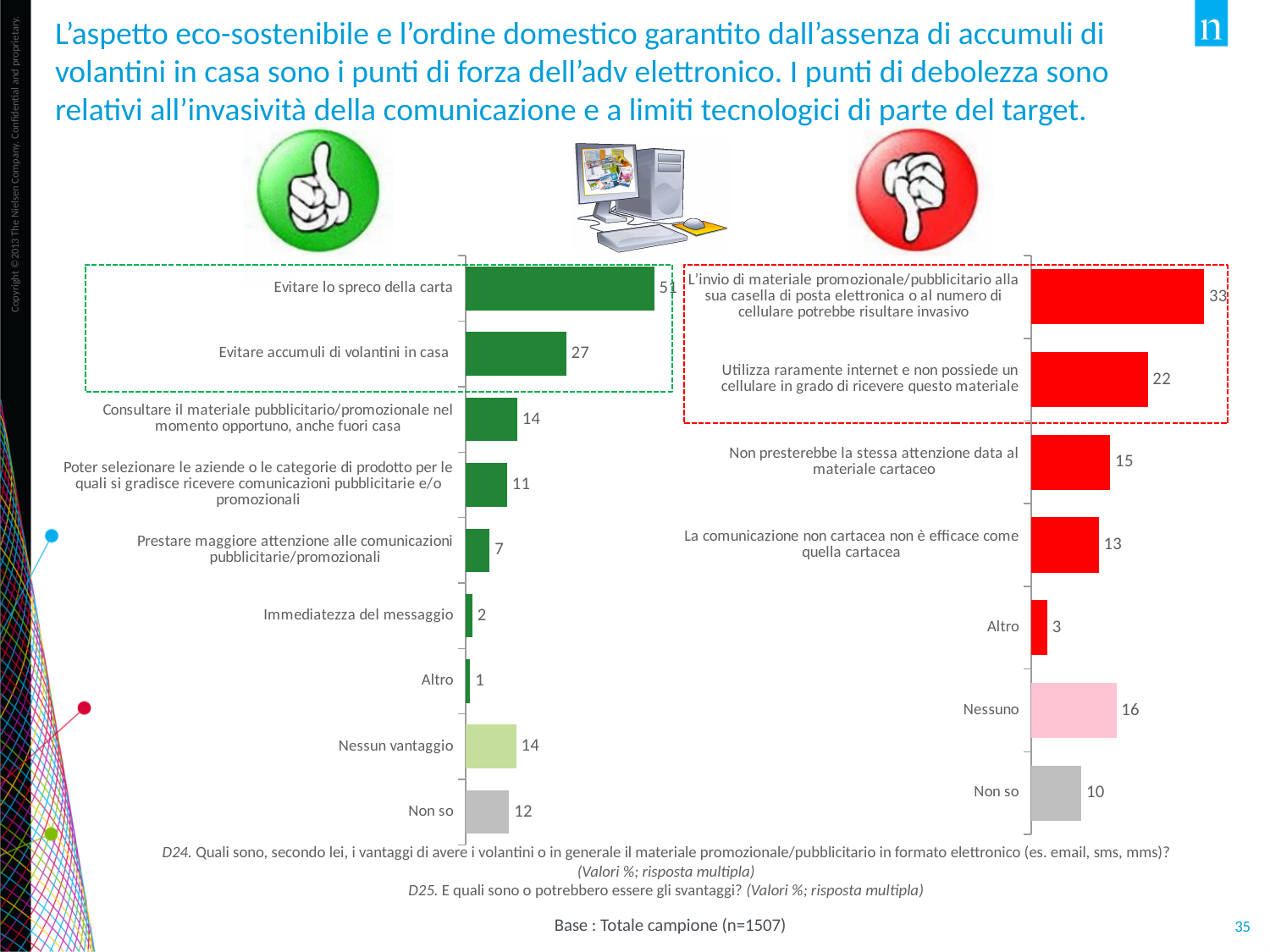
In the right chart (disadvantages), what is the value for "Nessuno"? 16 In the left chart (advantages), what is the value for "Evitare lo spreco della carta"? 51 How many categories are shown in the right chart (disadvantages)? 7 In the left chart (advantages), which category has the lowest value? Altro How many categories are shown in the left chart (advantages)? 9 What type of chart is the right chart (disadvantages)? Bar chart In the right chart (disadvantages), what is the value for "Utilizza raramente internet e non possiede un cellulare in grado di ricevere questo materiale"? 22 In the right chart (disadvantages), which category has the highest value? L'invio di materiale promozionale/pubblicitario alla sua casella di posta elettronica o al numero di cellulare potrebbe risultare invasivo In the left chart (advantages), what is the value for "Evitare accumuli di volantini in casa"? 27 In the left chart (advantages), what is the difference between "Evitare lo spreco della carta" and "Evitare accumuli di volantini in casa"? 24 In the left chart (advantages), which is larger: "Nessun vantaggio" or "Non so"? Nessun vantaggio In the right chart (disadvantages), what is the difference between "Non presterebbe la stessa attenzione data al materiale cartaceo" and "La comunicazione non cartacea non è efficace come quella cartacea"? 2